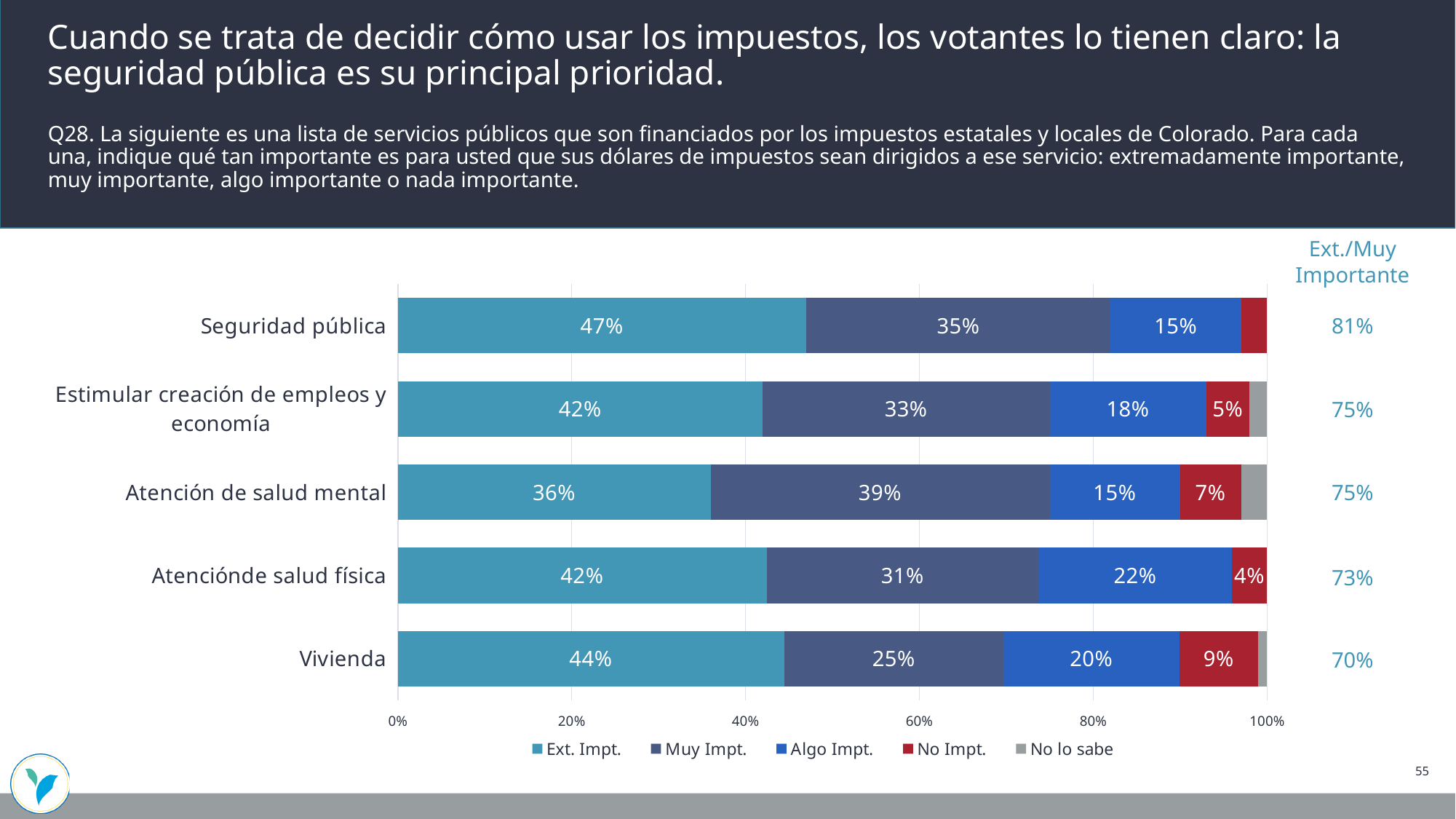
What is the difference in percentage points between the Algo Impt. value for Atenciónde salud física and for Atención de salud mental? 7 How many categories are shown in the chart? 5 What is the Ext./Muy Importante value shown for Vivienda? 70% What is the Muy Impt. value for Atención de salud mental? 39% Which category has the highest Ext./Muy Importante value? Seguridad pública What percentage of voters rated Seguridad pública as Ext. Impt.? 47% Which has a larger Muy Impt. value, Seguridad pública or Vivienda? Seguridad pública Which category has the lowest Ext. Impt. value? Atención de salud mental Which category has the highest Ext. Impt. value? Seguridad pública What kind of chart is shown on the slide? Stacked bar chart How many series does the legend list? 5 What is the No Impt. value for Vivienda? 9%